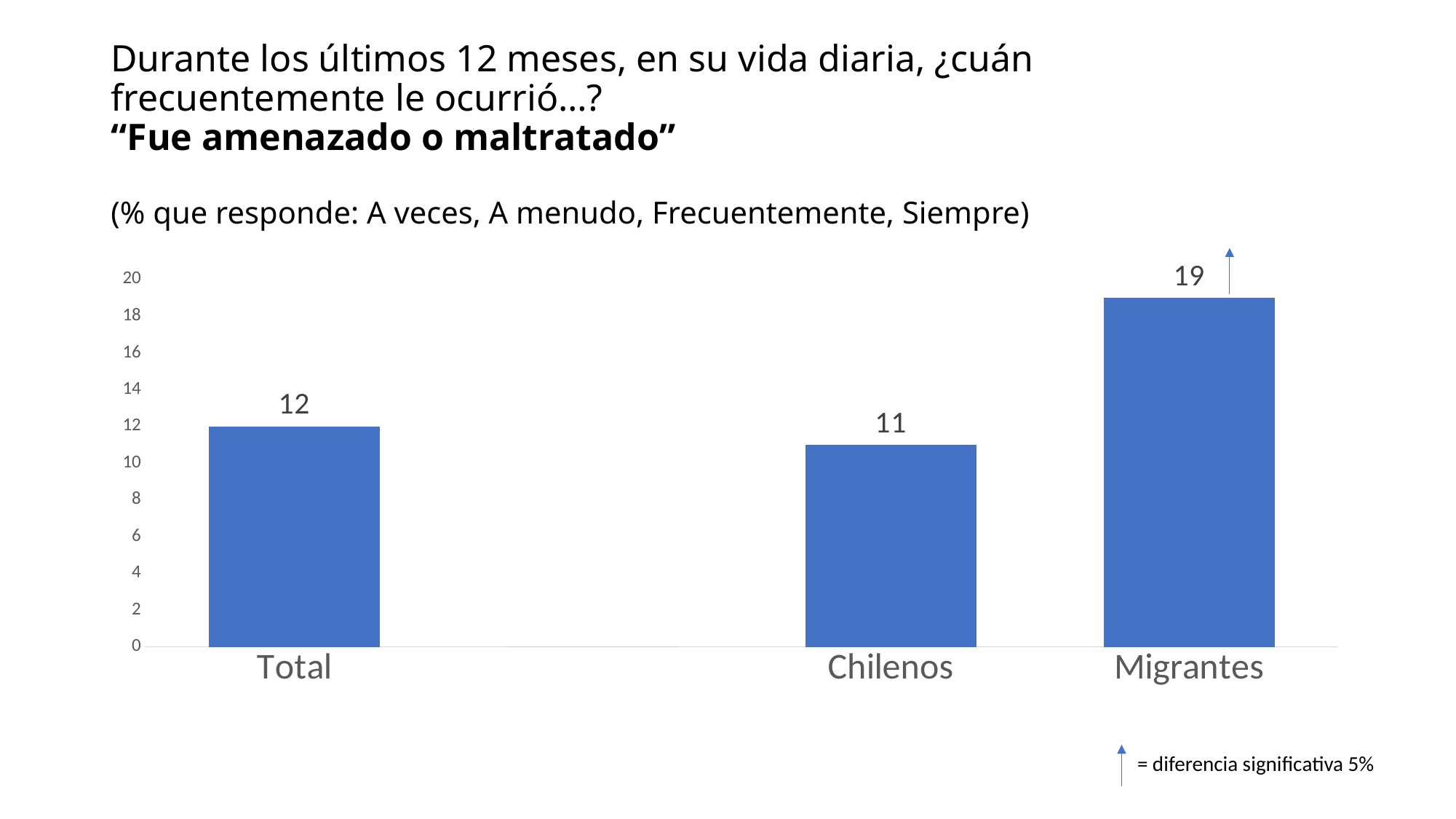
What is the value for Migrantes? 19 What is the difference between the values for Migrantes and Chilenos? 8 What is the value for Total? 12 Which category is marked with an arrow indicating a significant difference at 5%? Migrantes Which category has the highest value? Migrantes How many categories are shown on the x axis? 3 Which is larger, the value for Migrantes or the value for Total? Migrantes Is the value for Migrantes greater or less than 16? greater Which category has the lowest value? Chilenos What is the difference between the values for Migrantes and Total? 7 What is the value for Chilenos? 11 What kind of chart is shown on the slide? bar chart